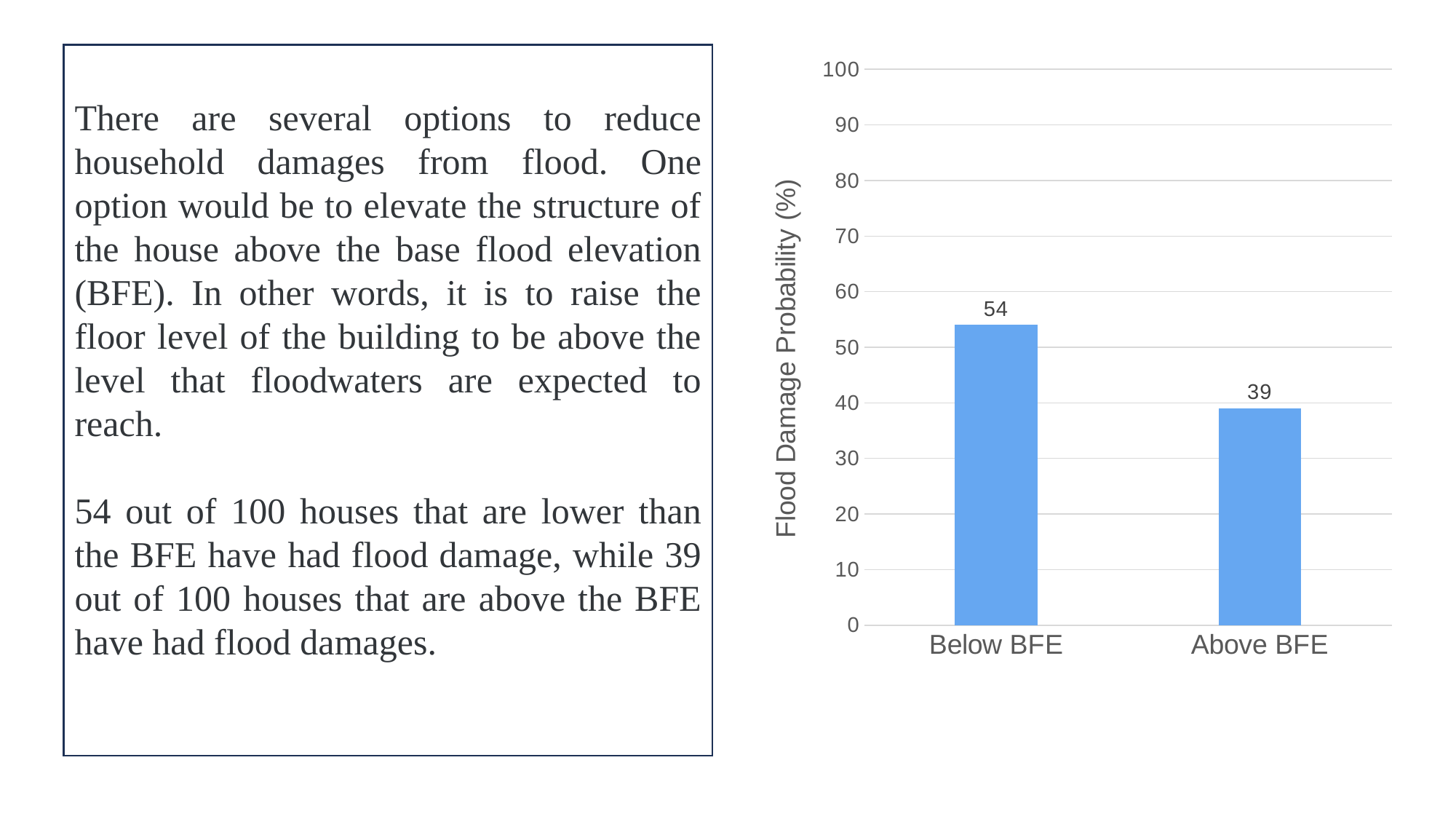
What is the label of the vertical axis of the chart? Flood Damage Probability (%) Which category has the lower flood damage probability? Above BFE What is the maximum value shown on the vertical axis of the chart? 100 Is the flood damage probability for Below BFE greater or less than 50? greater What kind of chart is shown on the slide? Bar chart Do the values fall or rise from Below BFE to Above BFE? fall Is the flood damage probability for Above BFE greater or less than 40? less What is the difference between the flood damage probability for Below BFE and Above BFE? 15 How many categories are shown on the chart? 2 What is the flood damage probability for Above BFE? 39 What is the flood damage probability for Below BFE? 54 Which category has the higher flood damage probability? Below BFE